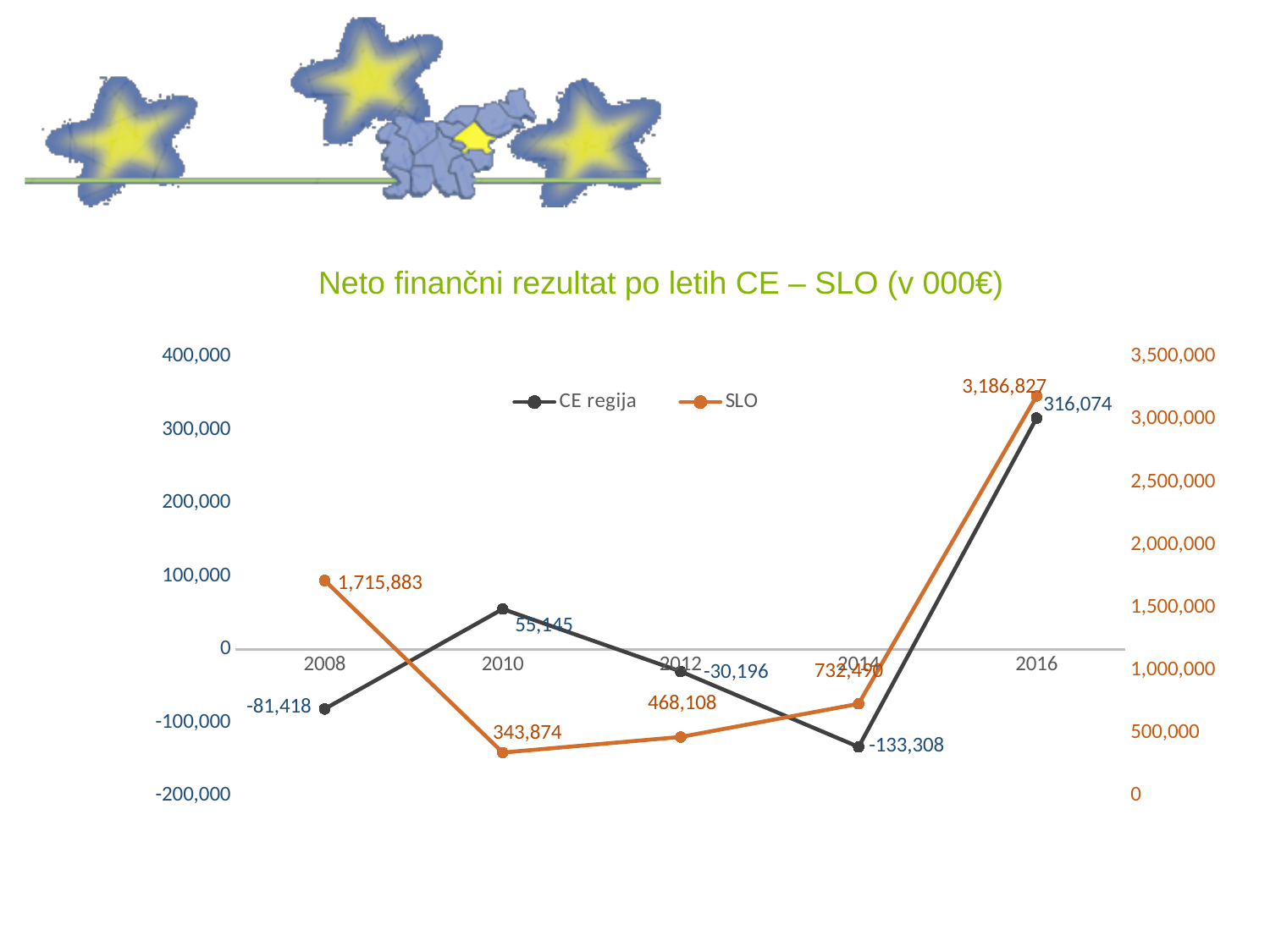
What is the title of the chart? Neto finančni rezultat po letih CE – SLO (v 000€) What kind of chart is shown on the slide? line chart What is the value for CE regija in 2008? -81,418 What is the value for CE regija in 2016? 316,074 What is the value for SLO in 2016? 3,186,827 Which is larger for SLO: the value in 2010 or the value in 2012? 2012 What is the value for SLO in 2010? 343,874 How many years are plotted along the x axis? 5 What is the difference between the SLO values for 2016 and 2008? 1,470,944 How many series does the legend list? 2 In which year is the CE regija value lowest? 2014 In which year is the SLO value highest? 2016